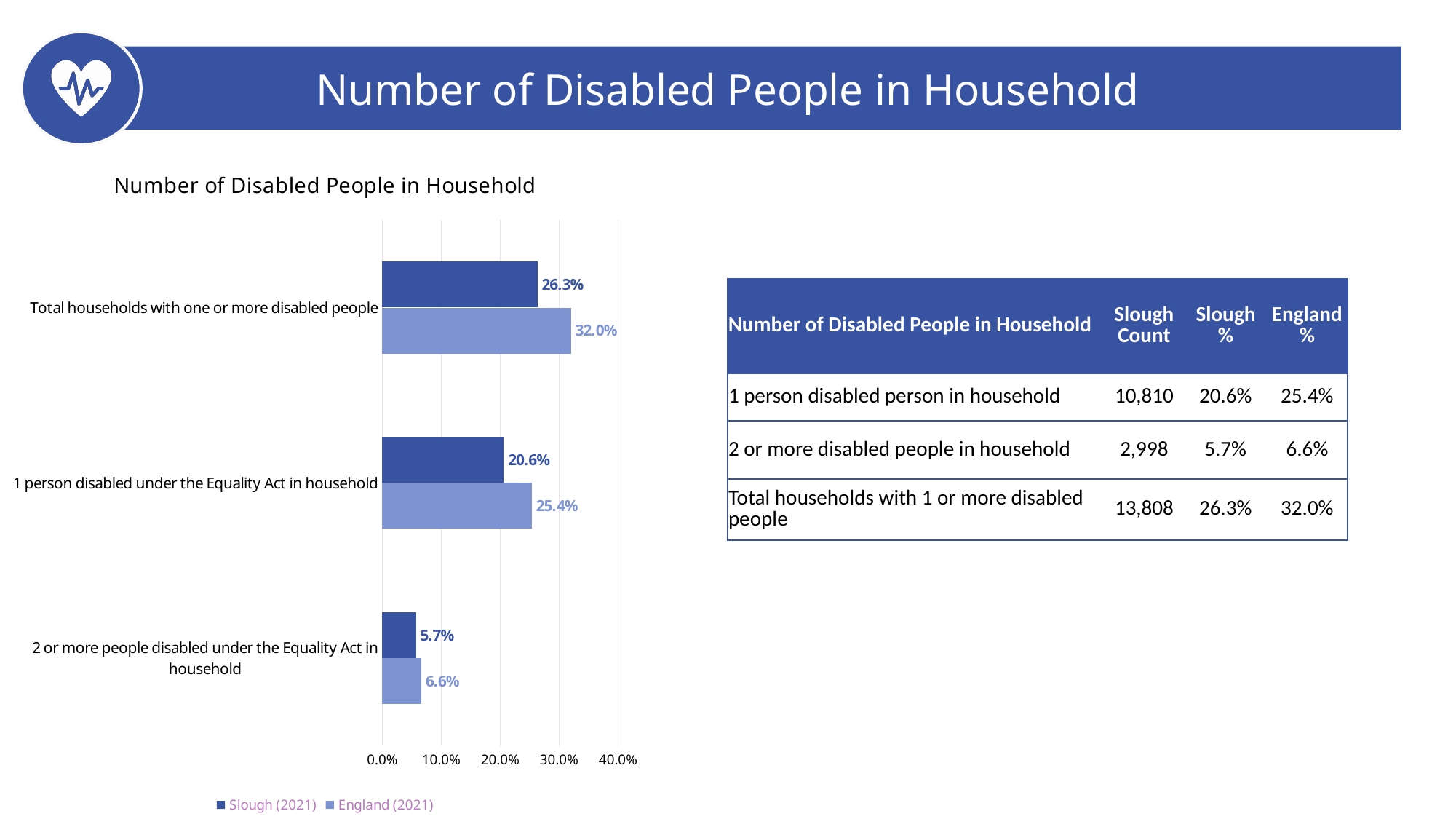
Which category has the lowest England (2021) value? 2 or more people disabled under the Equality Act in household What is the Slough (2021) value for 'Total households with one or more disabled people'? 26.3% Is the England (2021) value for 'Total households with one or more disabled people' greater or less than 30.0%? greater What is the difference between the England (2021) and Slough (2021) values for 'Total households with one or more disabled people'? 5.7% How many series does the legend list? 2 Which category has the highest Slough (2021) value? Total households with one or more disabled people For '1 person disabled under the Equality Act in household', which series has the larger value, Slough (2021) or England (2021)? England (2021) What type of chart is shown on the slide? Bar chart What is the England (2021) value for '1 person disabled under the Equality Act in household'? 25.4% What is the Slough (2021) value for '2 or more people disabled under the Equality Act in household'? 5.7% How many categories are shown on the chart? 3 What is the England (2021) value for 'Total households with one or more disabled people'? 32.0%